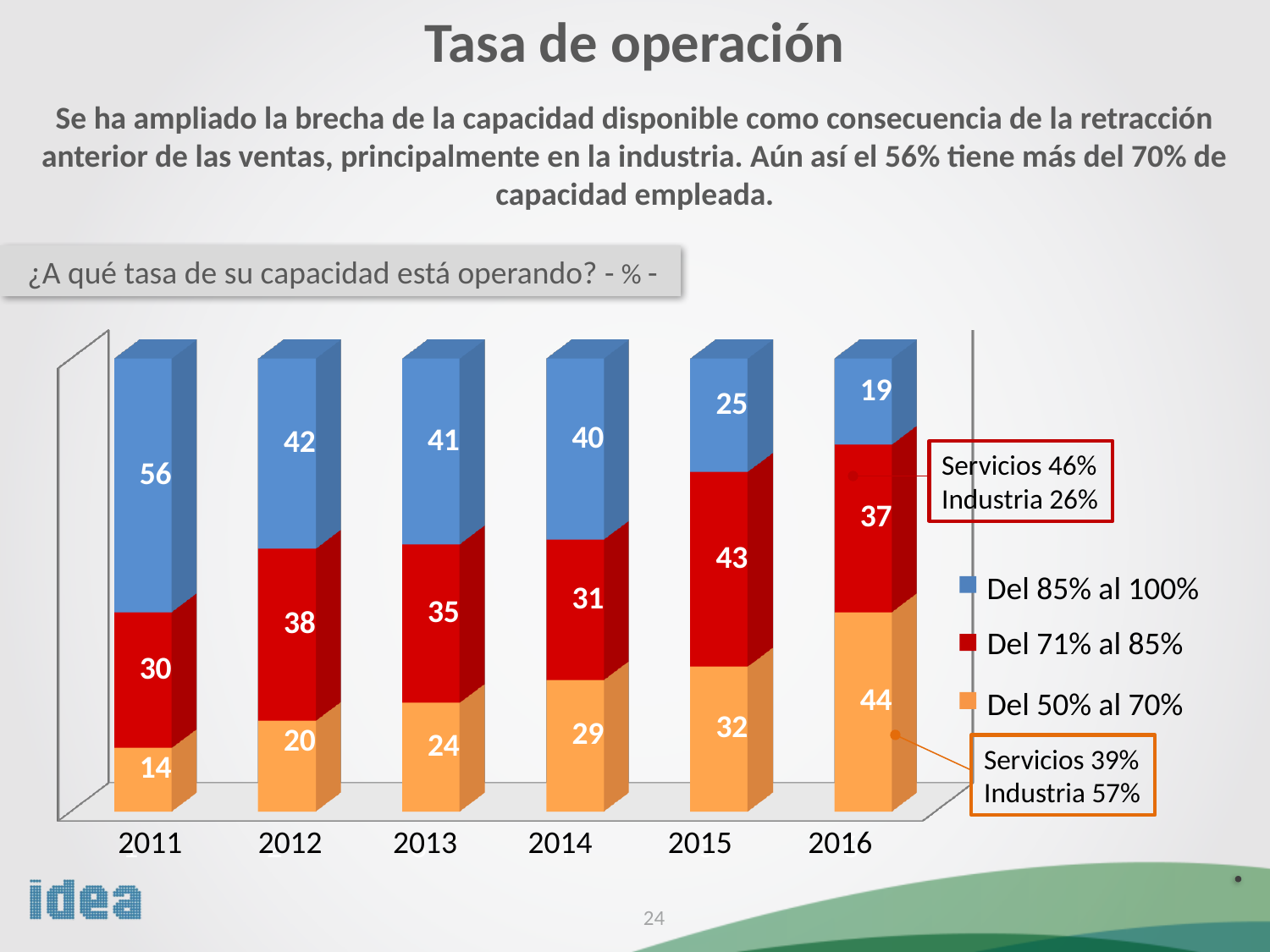
What is the value for 'Del 50% al 70%' in 2016? 44 In which year is the 'Del 85% al 100%' value the lowest? 2016 What is the value for 'Del 85% al 100%' in 2011? 56 What is the total of the stacked bar for 2013? 100 Which is larger in 2014: 'Del 71% al 85%' or 'Del 50% al 70%'? Del 71% al 85% What is the value for 'Del 71% al 85%' in 2015? 43 What type of chart is shown on the slide? Stacked bar chart How many years are shown on the x axis? 6 Does the 'Del 50% al 70%' series rise or fall from 2011 to 2016? Rise How many series does the legend list? 3 In which year is the 'Del 50% al 70%' value the highest? 2016 What is the difference between the 'Del 85% al 100%' values in 2011 and 2016? 37